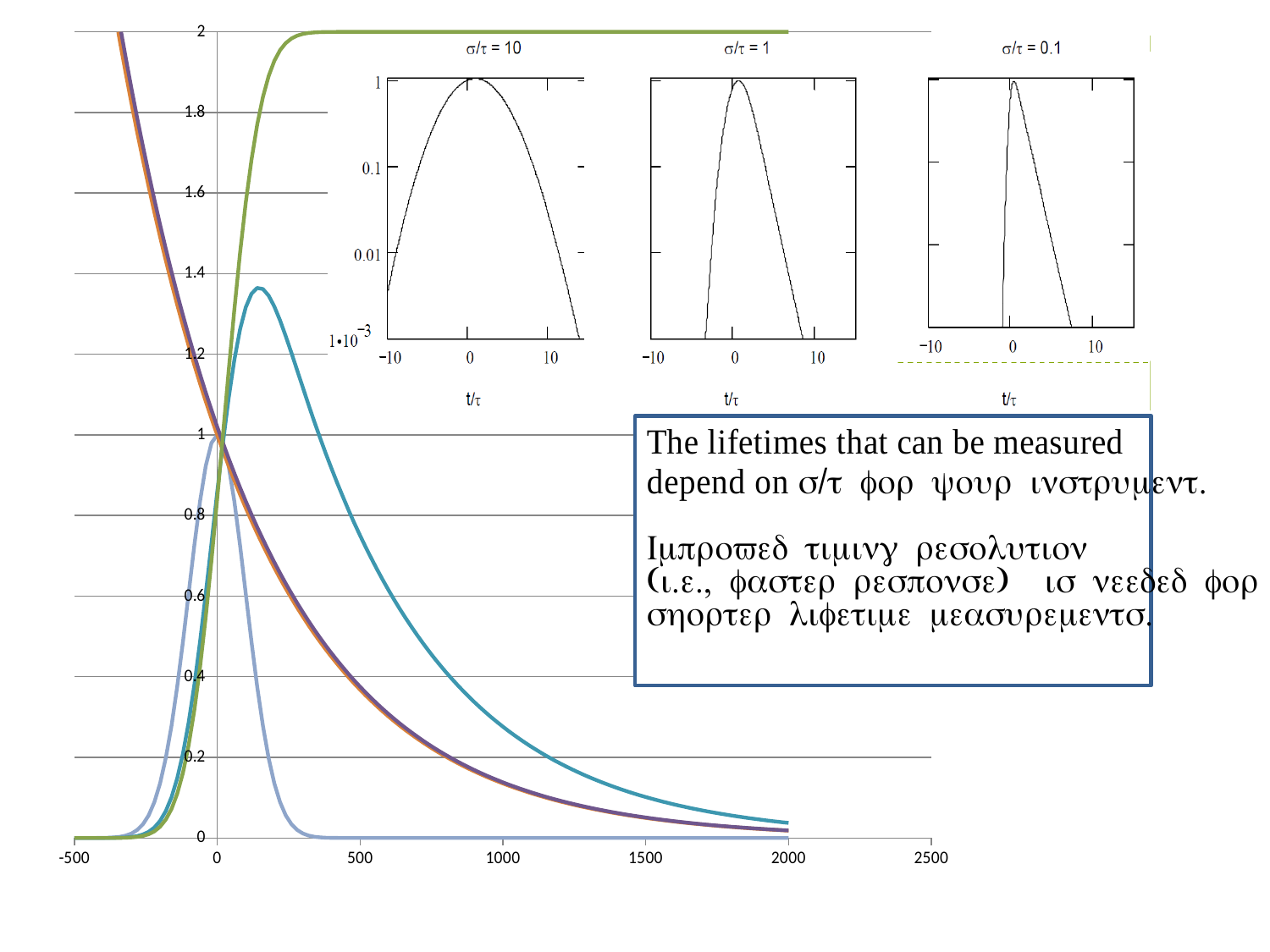
In the large chart, is the peak value of the teal curve greater or less than 1.2? greater In the large chart, does the orange/purple curve rise or fall as x increases from 0 to 2000? fall In the inset plots, is the peak of the σ/τ = 0.1 curve greater or less than 0.1? greater In the inset plots, does the σ/τ = 1 curve rise or fall as t/τ increases from 0 to 10? fall What kind of chart is the large chart on the left of the slide? line chart How many small inset plots are shown at the top of the slide? 3 What is the title of the leftmost inset plot? σ/τ = 10 In the large chart, is the value of the light blue curve at x = 500 greater or less than 0.2? less In the large chart, what value does the green curve level off at for large x? 2 In the large chart, what is the largest tick value shown on the x axis? 2500 In the large chart, does the green curve rise or fall as x increases from -500 to 500? rise